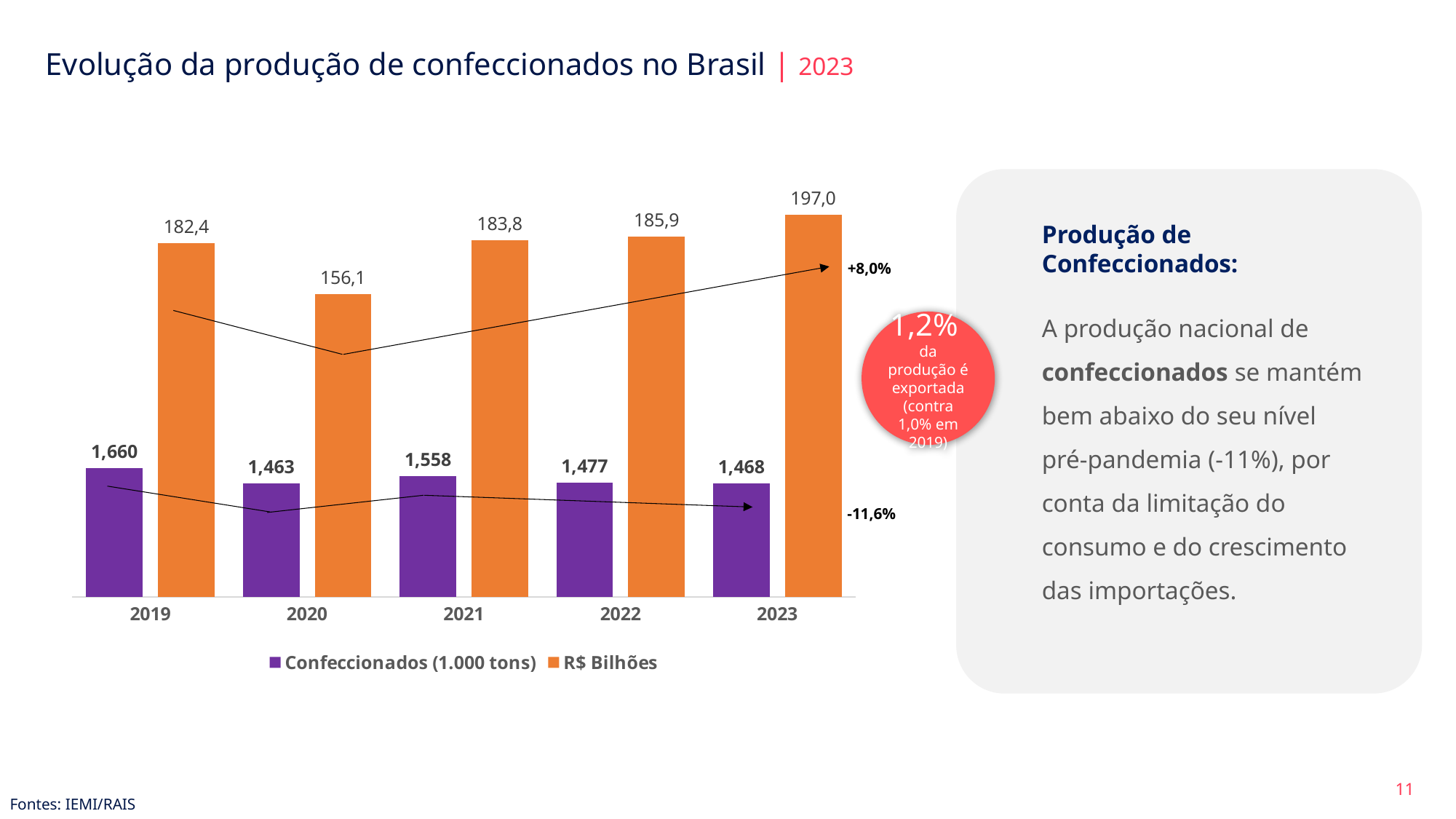
Which year has the lowest value for Confeccionados (1.000 tons)? 2020 What is the difference between the R$ Bilhões values for 2023 and 2019? 14,6 Which is larger, the Confeccionados (1.000 tons) value for 2021 or for 2022? 2021 What is the difference between the R$ Bilhões values for 2021 and 2020? 27,7 What is the value of R$ Bilhões for 2023? 197,0 How many years are shown on the x axis of the chart? 5 What is the value of R$ Bilhões for 2020? 156,1 What is the value of Confeccionados (1.000 tons) for 2019? 1,660 Which year has the highest value for R$ Bilhões? 2023 What kind of chart is shown on the slide? Bar chart How many series does the chart legend list? 2 What is the value of Confeccionados (1.000 tons) for 2022? 1,477